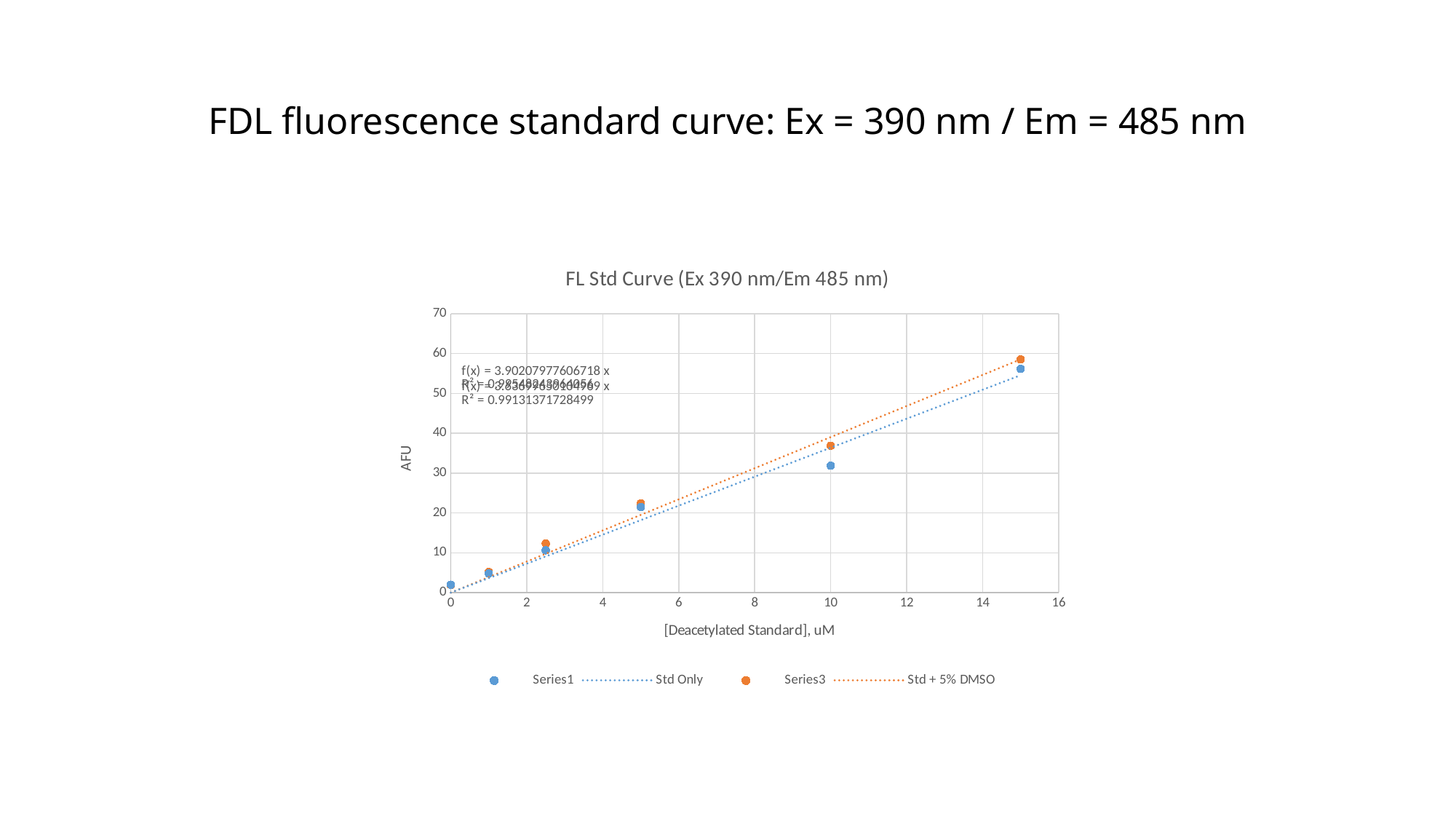
What is the title of the chart? FL Std Curve (Ex 390 nm/Em 485 nm) What kind of chart is shown on the slide? Scatter chart Is the Series3 value at 10 uM greater or less than 40? less Is the Series1 value at 5 uM greater or less than 30? less What is the label of the y axis? AFU At which concentration does Series3 reach its highest AFU value? 15 At 10 uM, which series has the higher AFU value, Series1 or Series3? Series3 Is the Series3 value at 15 uM greater or less than 50? greater Do the AFU values rise or fall as the deacetylated standard concentration increases? Rise How many entries does the chart legend list? 4 How many data points are plotted for Series1? 6